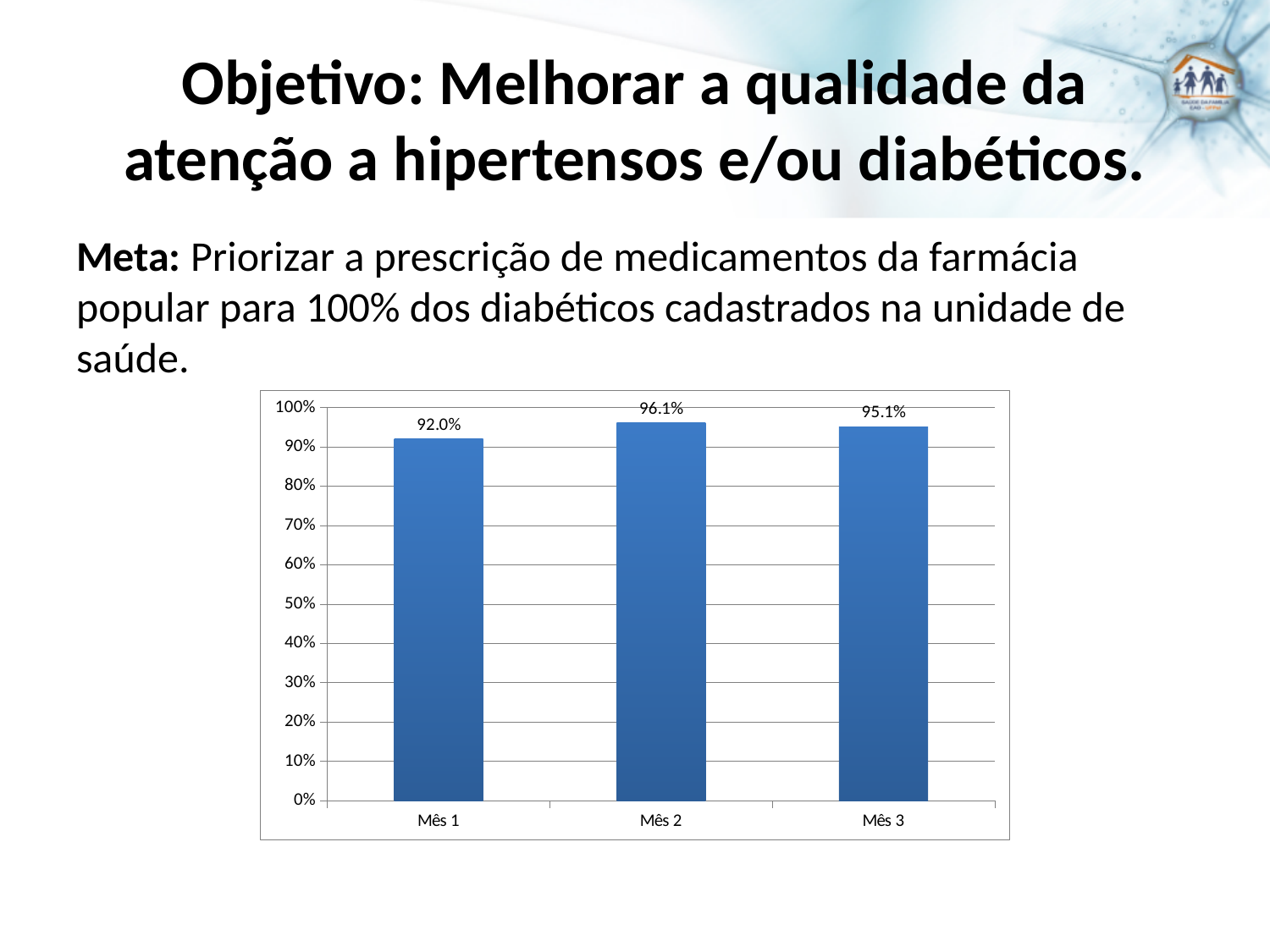
What is the value for Mês 3? 95.1% What is the highest value shown on the y axis? 100% What is the difference between the values for Mês 2 and Mês 3? 1.0% What is the value for Mês 1? 92.0% Is the value for Mês 1 greater or less than 90%? greater How many categories are shown on the x axis? 3 Which month has the lowest value? Mês 1 Which month has the highest value? Mês 2 What is the difference between the values for Mês 2 and Mês 1? 4.1% Which is larger, the value for Mês 1 or the value for Mês 3? Mês 3 What is the value for Mês 2? 96.1% What kind of chart is shown on the slide? bar chart